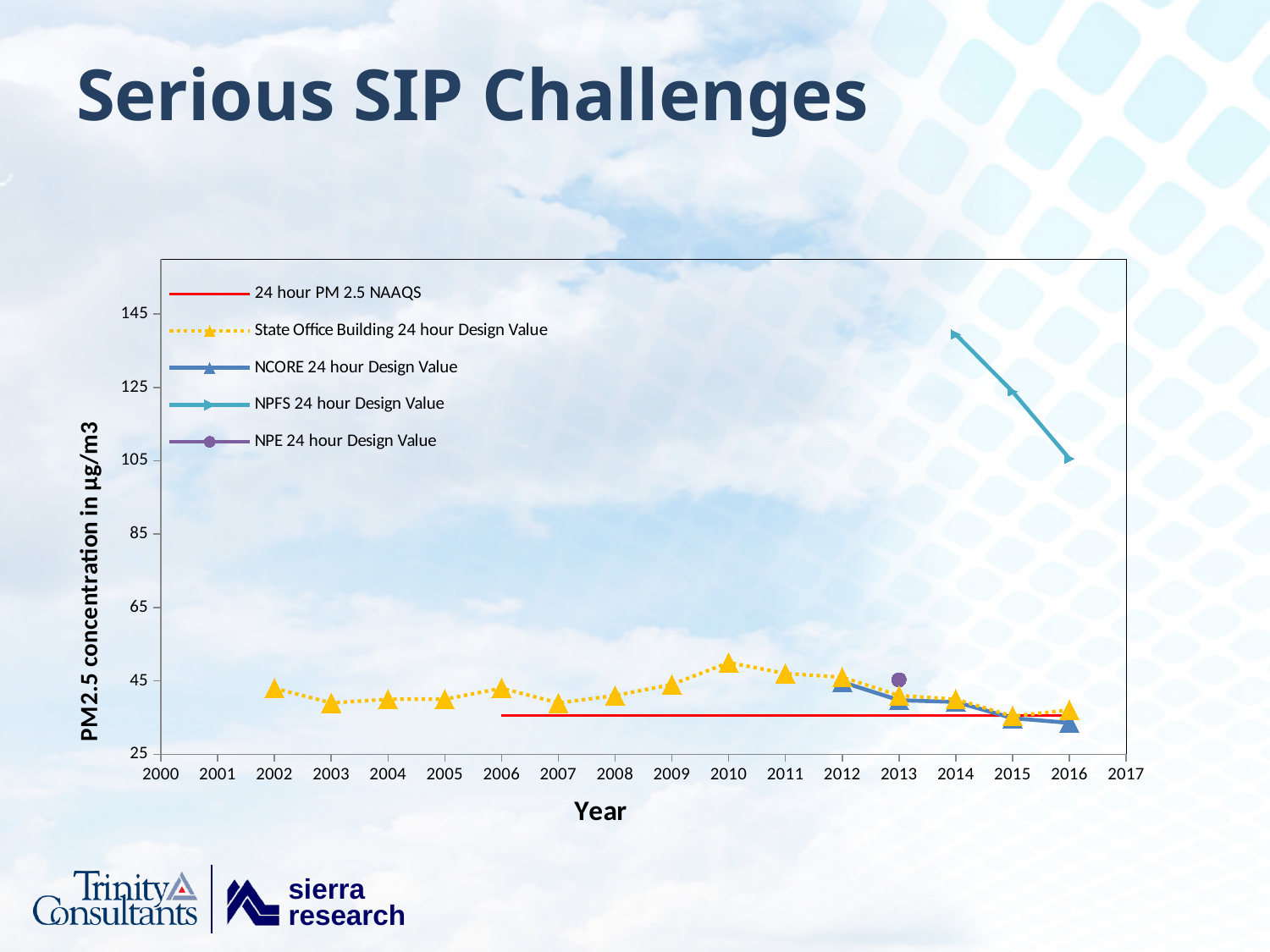
How many series does the legend list? 5 Is the State Office Building 24 hour Design Value for 2010 greater or less than 65? less In which year is the State Office Building 24 hour Design Value highest? 2010 Do the NPFS 24 hour Design Values rise or fall from 2014 to 2016? fall What is the label on the vertical axis of the chart? PM2.5 concentration in µg/m3 Which is larger in 2014, the NPFS 24 hour Design Value or the State Office Building 24 hour Design Value? NPFS 24 hour Design Value Is the NPFS 24 hour Design Value for 2016 greater or less than 85? greater Do the NCORE 24 hour Design Values rise or fall from 2012 to 2016? fall Which series reaches the highest values on the chart? NPFS 24 hour Design Value Is the NCORE 24 hour Design Value for 2016 greater or less than 45? less What kind of chart is shown on the slide? line chart